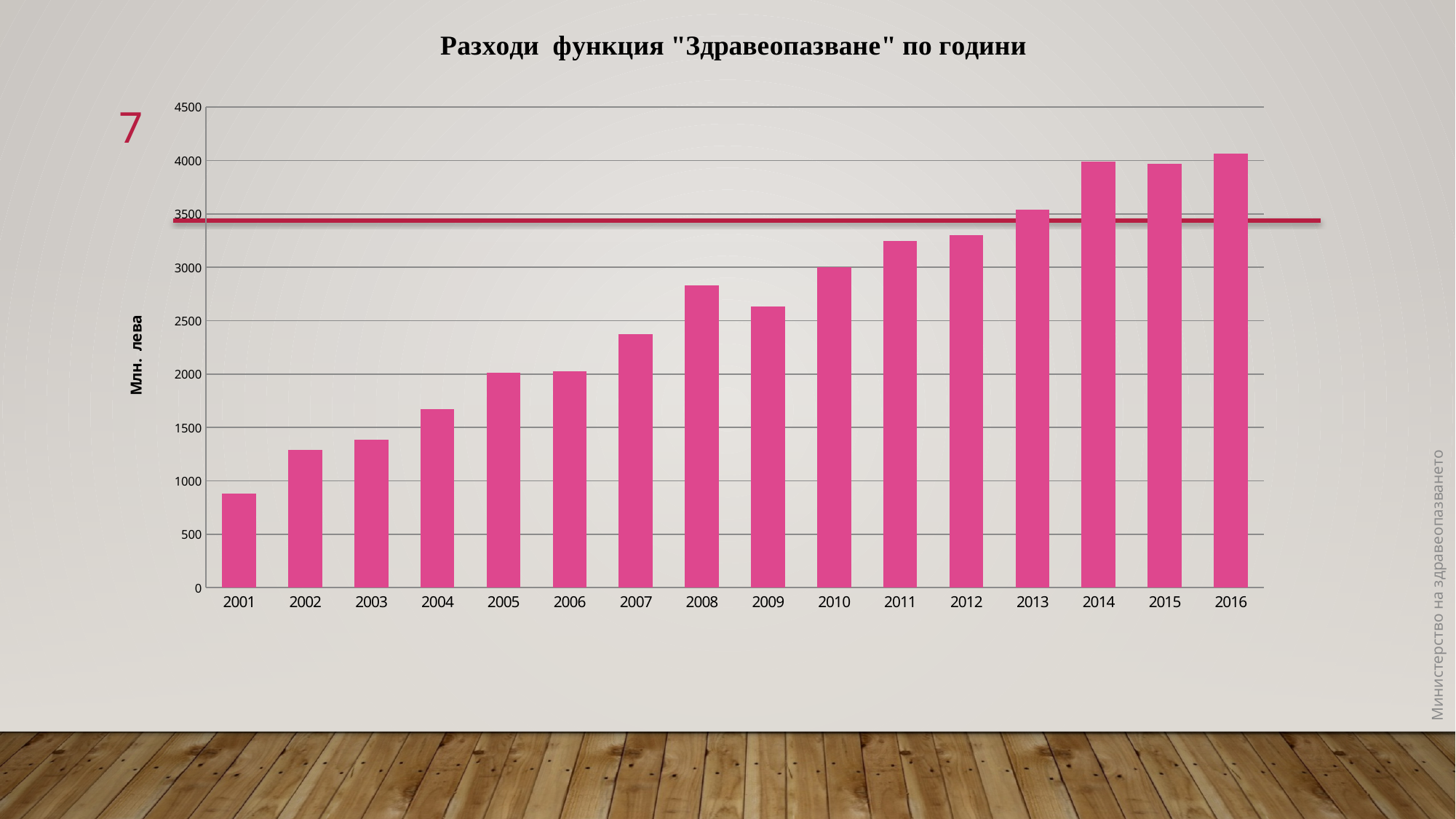
What is the label on the y axis of the chart? Млн. лева Is the value for 2016 greater or less than 4000? greater Is the value for 2004 greater or less than 1500? greater Which year has the lowest value in the chart? 2001 Which year has the highest value in the chart? 2016 Is the value for 2008 greater or less than 3000? less Which year has the larger value, 2008 or 2009? 2008 Do the values generally rise or fall from 2001 to 2016? rise How many years are shown on the x axis of the chart? 16 What kind of chart is shown on the slide? bar chart